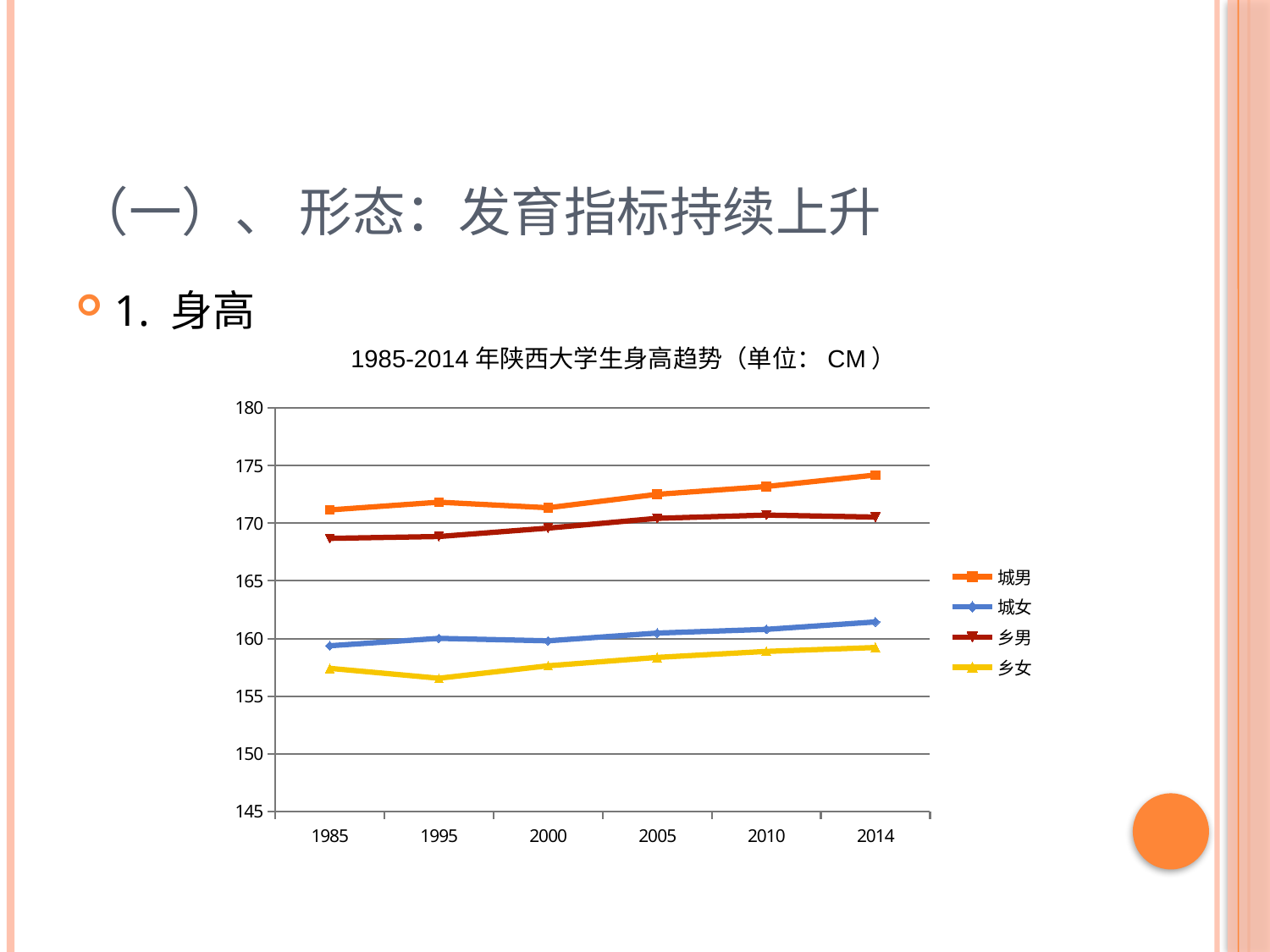
What is the title of the chart? 1985-2014 年陕西大学生身高趋势（单位： CM） What kind of chart is shown on the slide? line chart How many series does the legend list? 4 Does the 城男 line rise or fall from 1985 to 2014? rise In 2005, which is larger, the value for 城男 or the value for 乡男? 城男 Is the value for 城男 in 2014 greater or less than 170? greater Which series has the highest value in 2014? 城男 How many years are shown on the x axis? 6 Is the value for 乡女 in 1995 greater or less than 160? less Which series has the lowest value in 1985? 乡女 Is the value for 城女 in 2014 greater or less than 160? greater